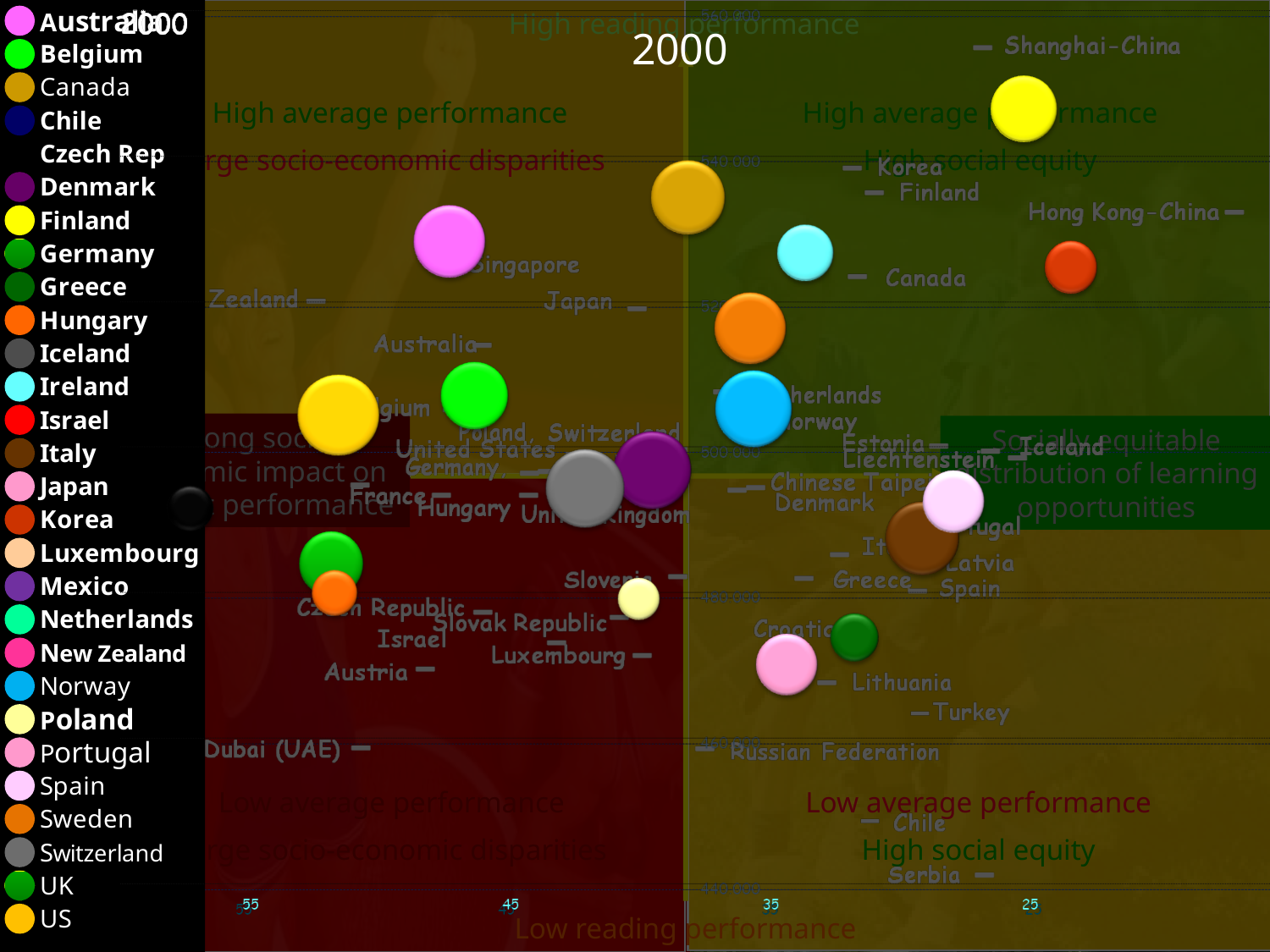
What kind of chart is shown on the slide? bubble chart Which bubble is positioned higher on the chart, Finland or Japan? Finland Is the x-axis value for US greater or less than 45? greater Which country's bubble is furthest to the right on the chart? Korea Is the x-axis value for Finland greater or less than 35? less Which country's bubble is positioned highest on the chart? Finland What label is written along the bottom of the chart below the x axis? Low reading performance Is the x-axis value for Spain greater or less than 35? less How many countries does the legend on the left list? 28 What is the title shown at the top of the chart? 2000 Which bubble is further to the right on the chart, Korea or US? Korea